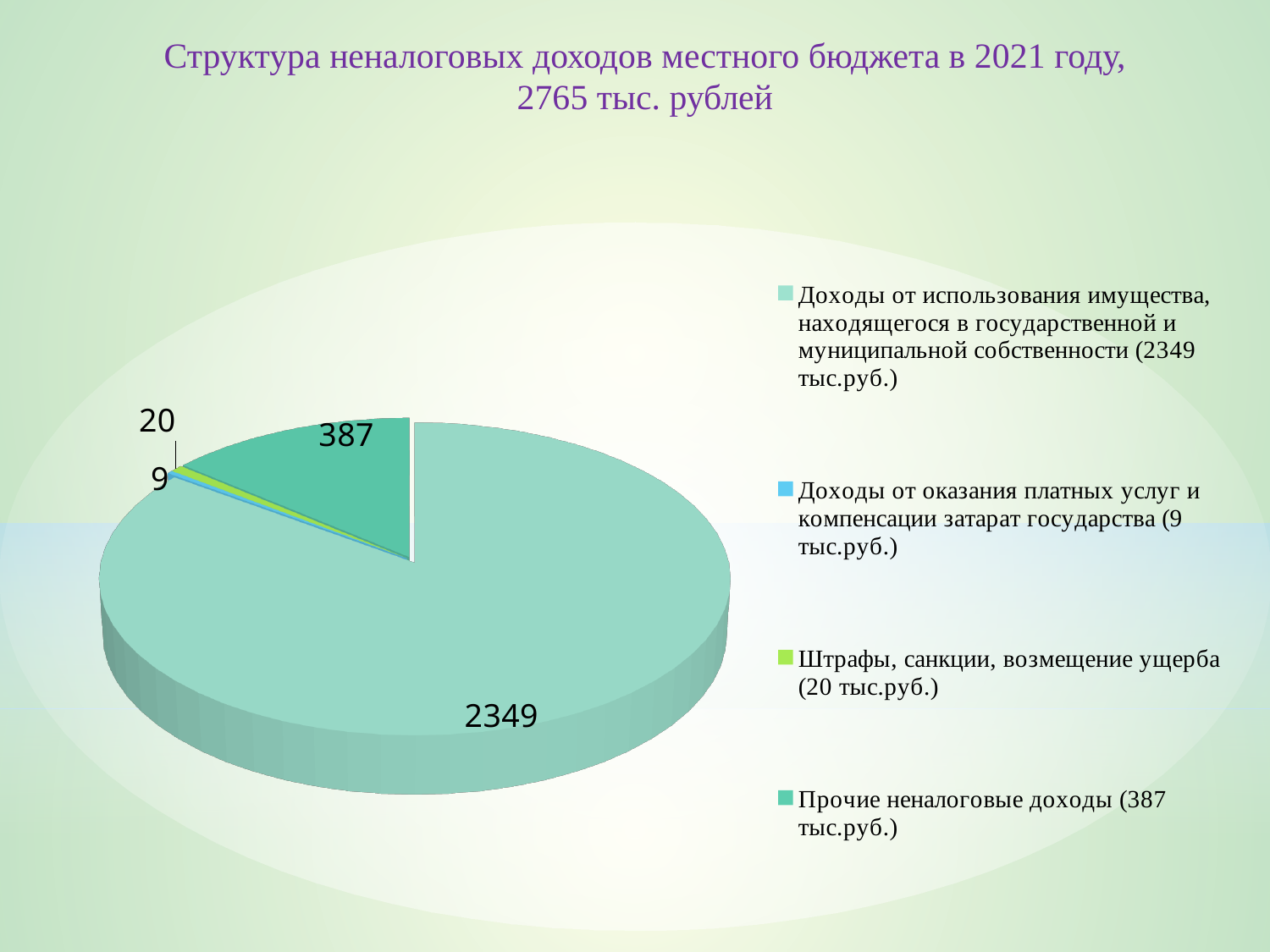
What is the value for "Прочие неналоговые доходы"? 387 What kind of chart is shown on the slide? pie chart What is the total of all the slices in the pie chart? 2765 Which category has the smallest slice of the pie? Доходы от оказания платных услуг и компенсации затарат государства How many slices does the pie chart have? 4 What is the title of the chart? Структура неналоговых доходов местного бюджета в 2021 году, 2765 тыс. рублей What is the value for "Доходы от оказания платных услуг и компенсации затарат государства"? 9 What is the value for "Штрафы, санкции, возмещение ущерба"? 20 Which category has the largest slice of the pie? Доходы от использования имущества, находящегося в государственной и муниципальной собственности Which is larger: the value for "Штрафы, санкции, возмещение ущерба" or the value for "Доходы от оказания платных услуг"? Штрафы, санкции, возмещение ущерба What is the value for "Доходы от использования имущества, находящегося в государственной и муниципальной собственности"? 2349 What is the difference between the value for "Доходы от использования имущества" and the value for "Прочие неналоговые доходы"? 1962